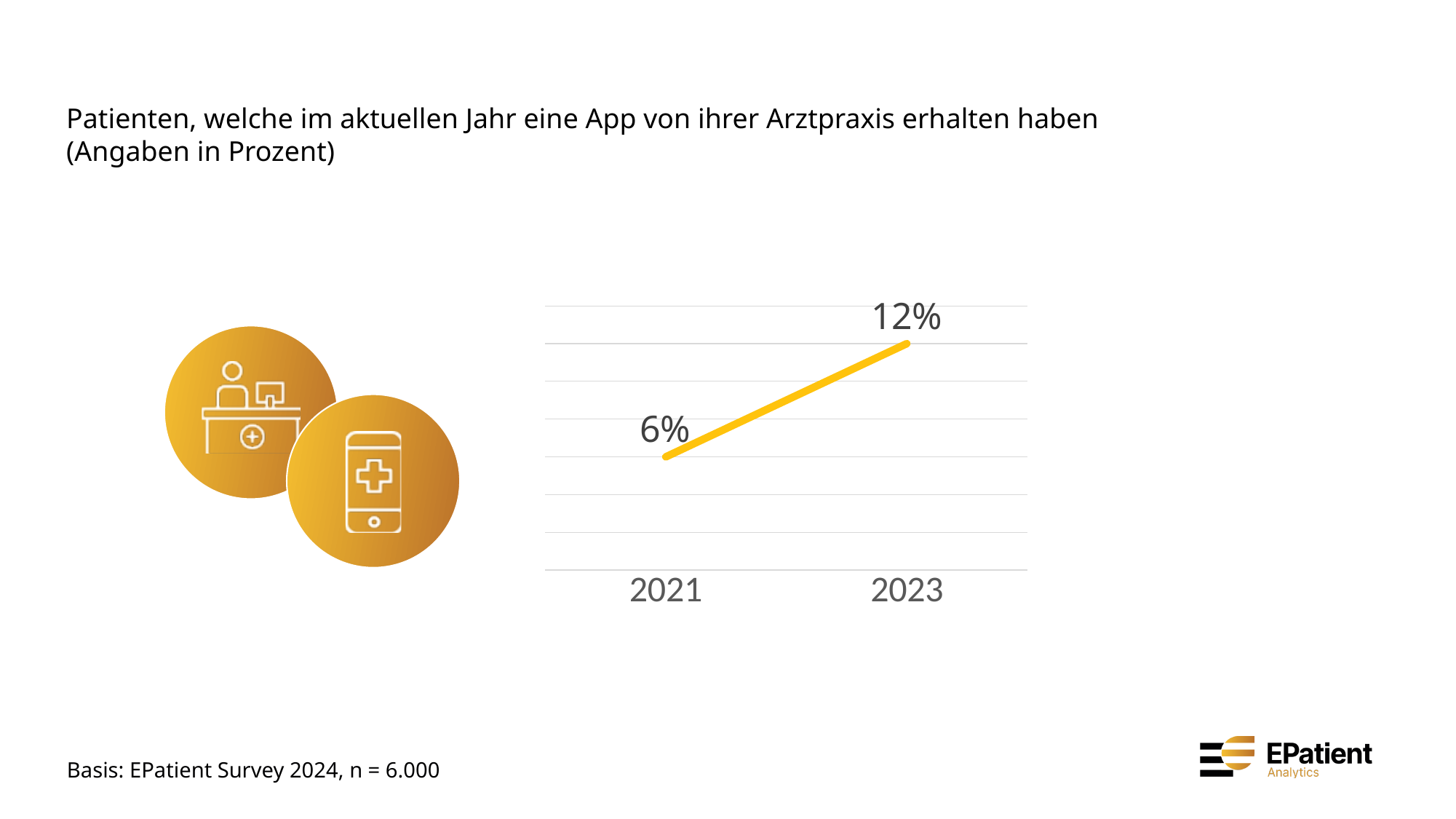
What kind of chart is shown on the slide? line chart What colour is the line in the chart? yellow Which is larger, the value for 2021 or the value for 2023? 2023 What is the difference between the values for 2023 and 2021? 6% Which year has the highest value? 2023 How many data points are plotted on the chart? 2 Do the values rise or fall from 2021 to 2023? rise What is the value for 2021? 6% What is the value for 2023? 12% Which year has the lowest value? 2021 What is the sample size (n) stated in the source note on the slide? 6.000